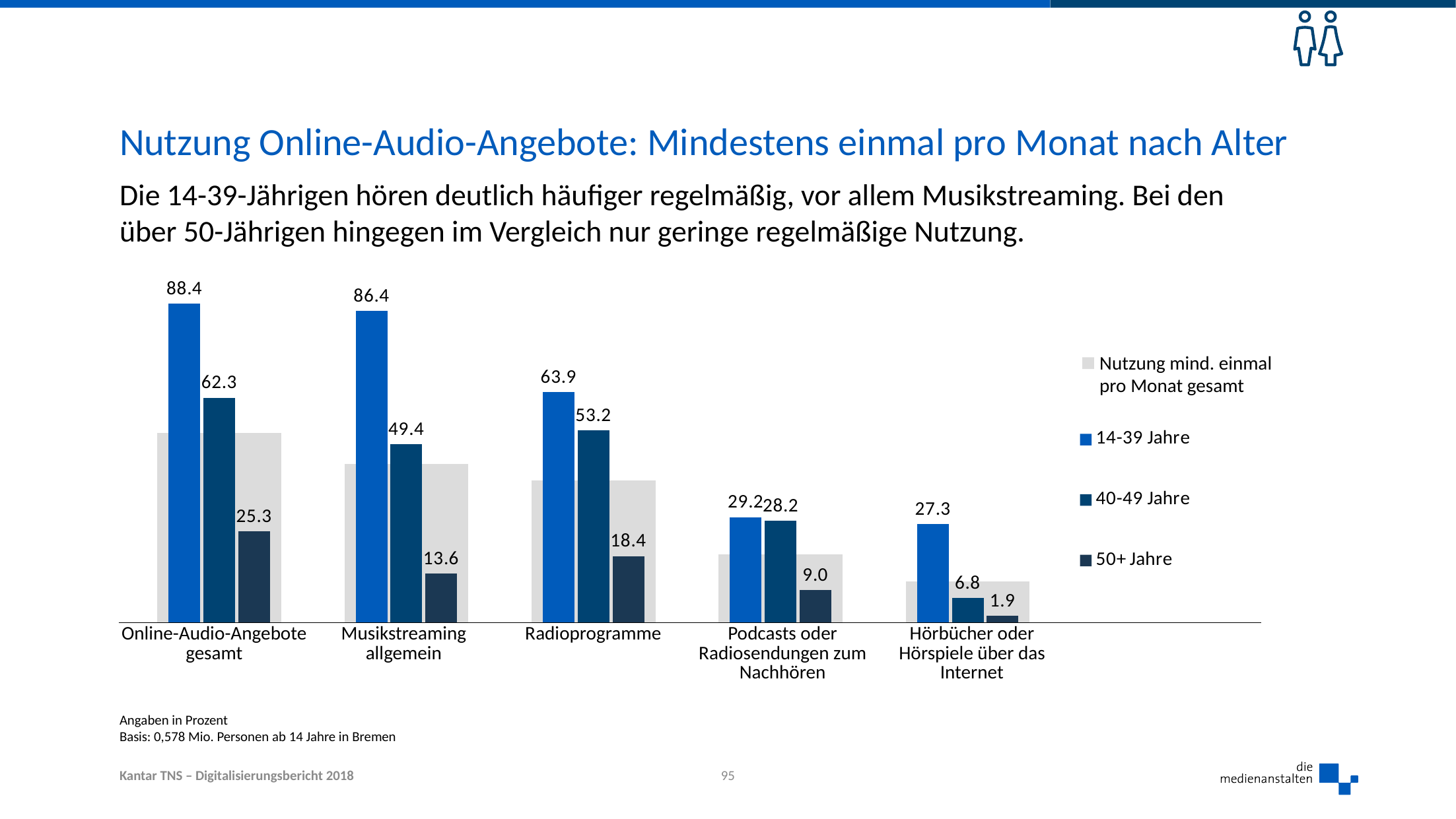
What is the difference between the 14-39 Jahre and 50+ Jahre values in the Musikstreaming allgemein category? 72.8 What kind of chart is shown on the slide? Bar chart What is the value for 14-39 Jahre in the Musikstreaming allgemein category? 86.4 How many categories are shown on the x axis? 5 Which category has the lowest value for the 50+ Jahre series? Hörbücher oder Hörspiele über das Internet What is the value for 40-49 Jahre in the Online-Audio-Angebote gesamt category? 62.3 How many series does the legend list? 4 What is the difference between the 40-49 Jahre and 50+ Jahre values in the Radioprogramme category? 34.8 Which is larger in the Podcasts oder Radiosendungen zum Nachhören category: the 40-49 Jahre value or the 50+ Jahre value? 40-49 Jahre What is the value for 50+ Jahre in the Radioprogramme category? 18.4 What is the value for 50+ Jahre in the Hörbücher oder Hörspiele über das Internet category? 1.9 Which category has the highest value for the 14-39 Jahre series? Online-Audio-Angebote gesamt